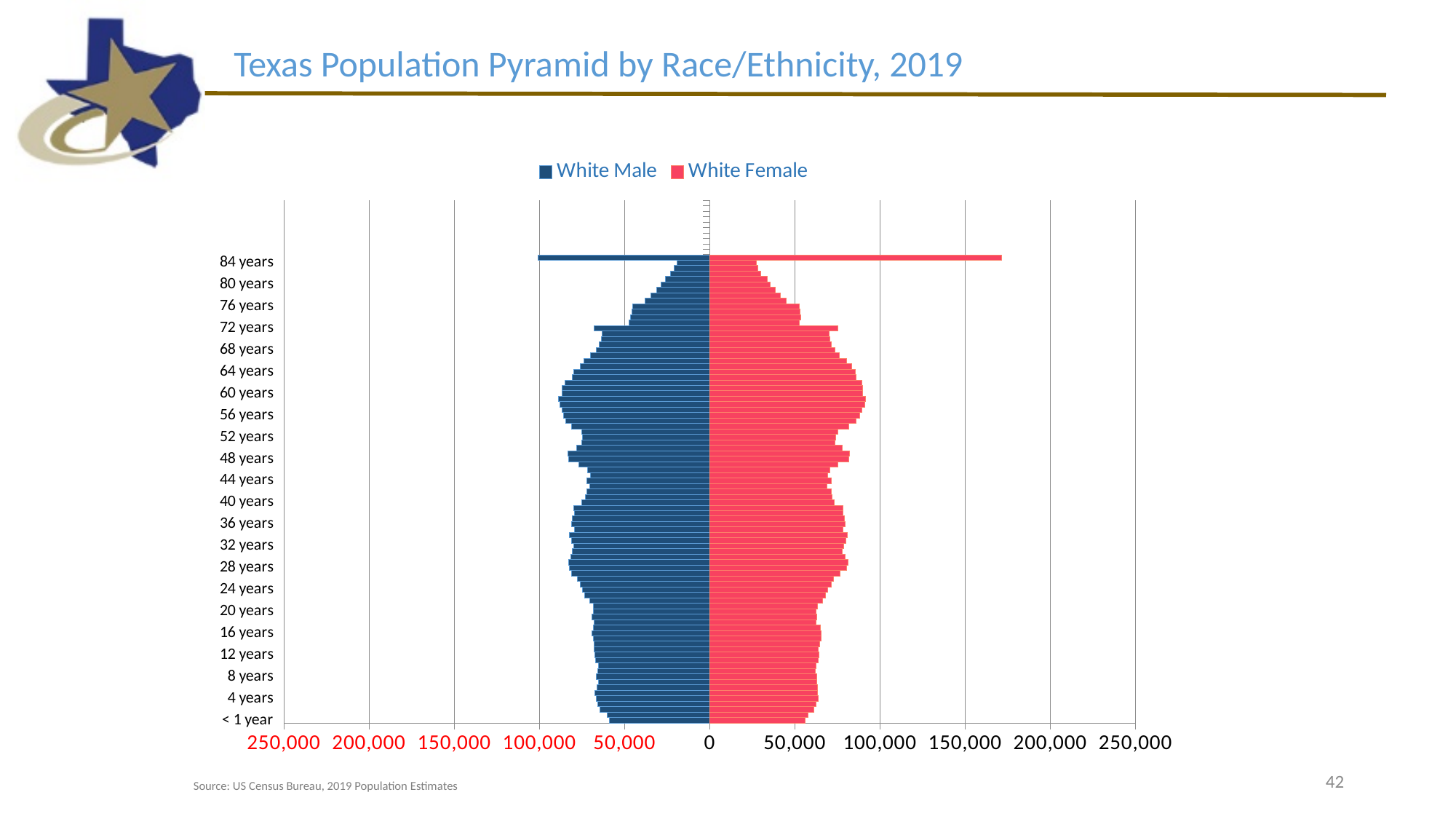
Is the White Female value for 60 years greater or less than 100,000? less At 84 years, which is larger: the White Male value or the White Female value? White Female Is the White Female value for 84 years greater or less than 150,000? less Is the White Male value for < 1 year greater or less than 100,000? less What is the title of the chart? Texas Population Pyramid by Race/Ethnicity, 2019 Which colour represents White Female in the chart? Red/pink How many series does the legend list? 2 Which is larger: the White Female value for 84 years or the White Female value for 72 years? 72 years What kind of chart is shown on the slide? bar chart